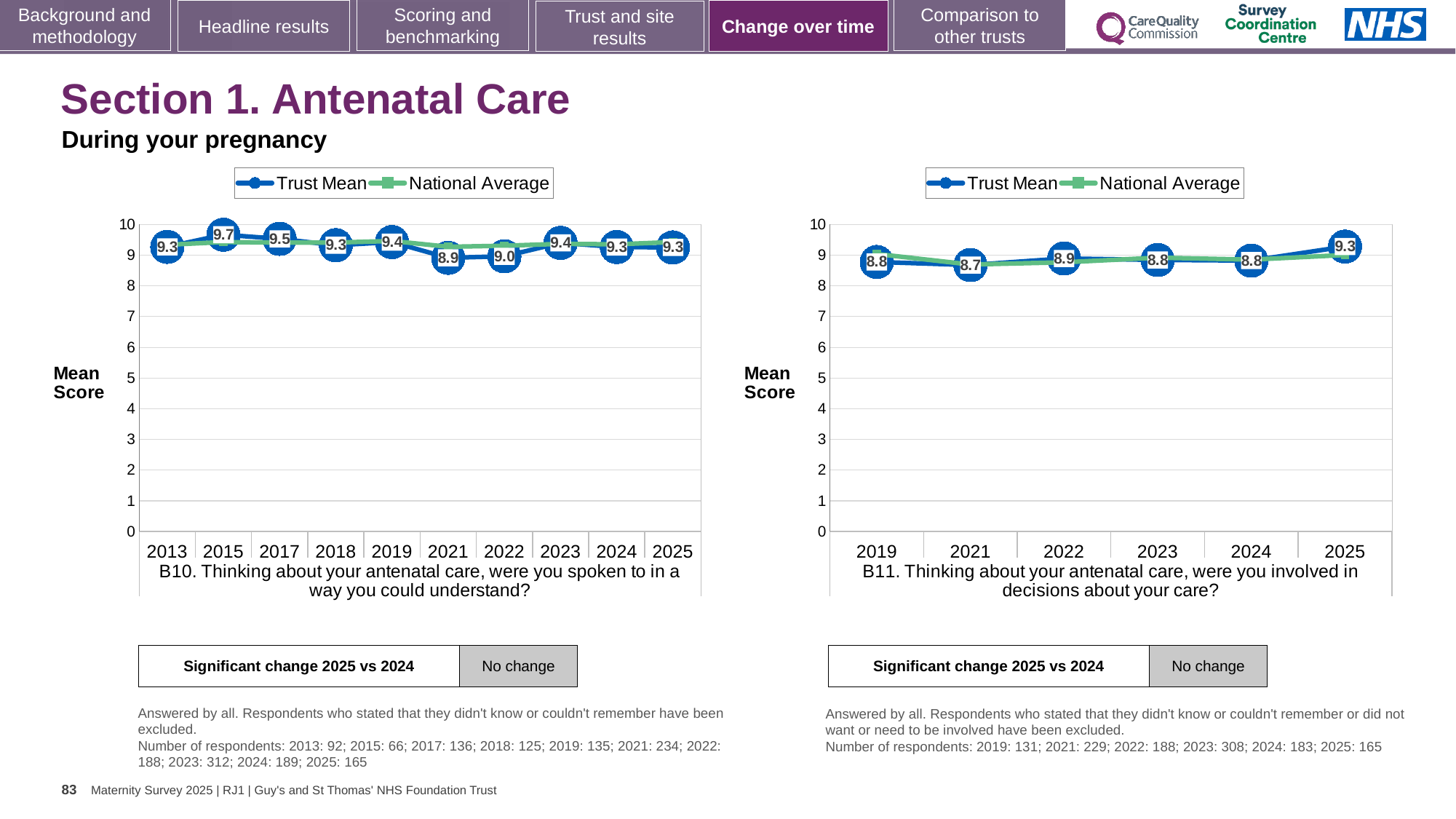
In the B10 chart (left), what is the Trust Mean score for 2021? 8.9 In the B10 chart (left), what is the Trust Mean score for 2015? 9.7 How many years are shown on the x axis of the B10 chart (left)? 10 In the B11 chart (right), what is the difference between the Trust Mean scores for 2025 and 2024? 0.5 In the B11 chart (right), is the Trust Mean score for 2025 greater or less than 9? greater In the B10 chart (left), which year has the lowest Trust Mean score? 2021 In the B10 chart (left), which year has the highest Trust Mean score? 2015 In the B11 chart (right), what is the Trust Mean score for 2025? 9.3 In the B11 chart (right), which year has the lowest Trust Mean score? 2021 How many series does the legend of the B11 chart (right) list? 2 What kind of chart is the B10 chart (left)? Line chart In the B10 chart (left), what is the difference between the Trust Mean scores for 2015 and 2021? 0.8